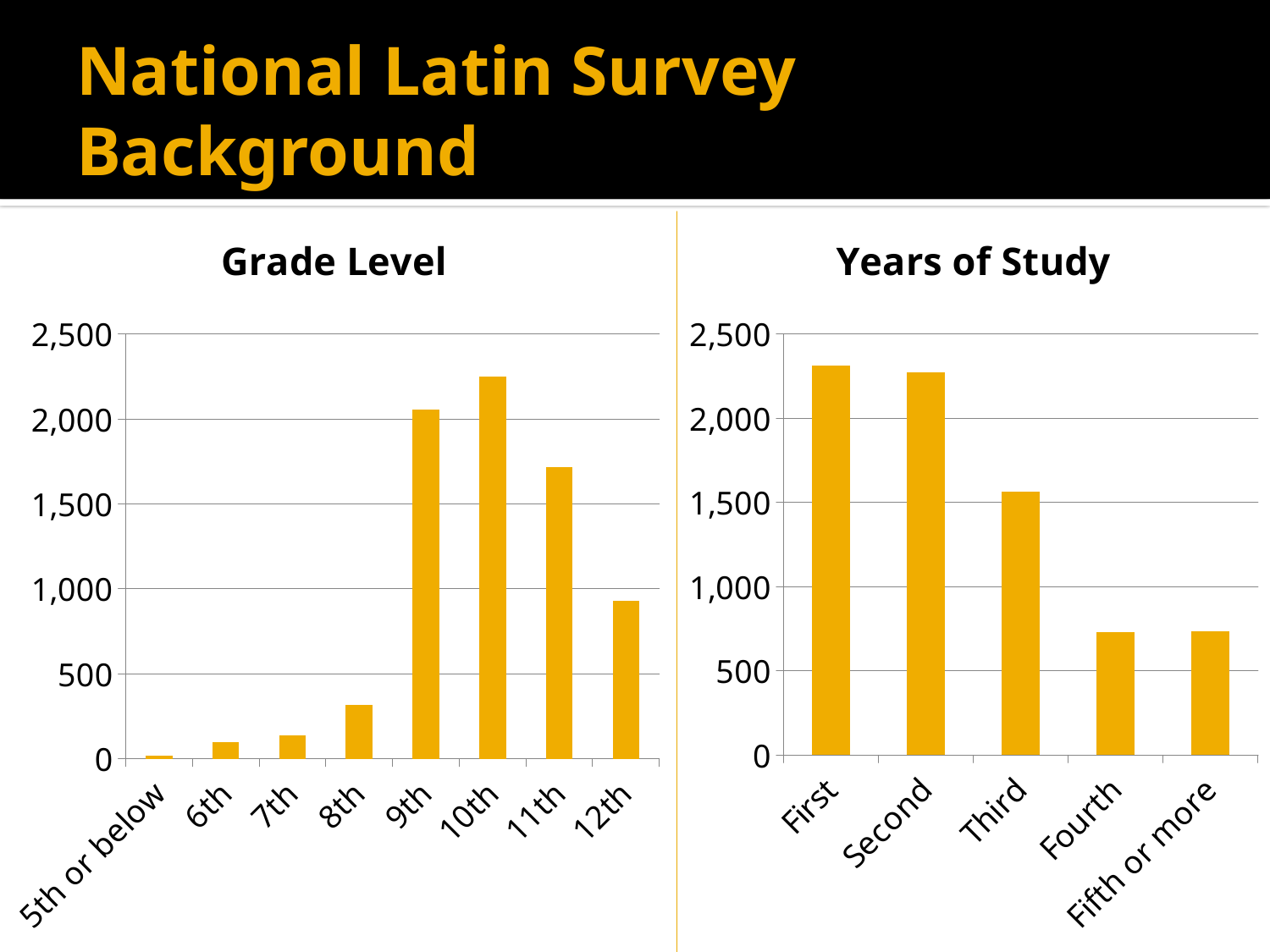
In the Grade Level chart, which category has the lowest value? 5th or below In the Grade Level chart, is the value for 12th greater or less than 1,000? less How many grade categories are shown in the Grade Level chart? 8 In the Years of Study chart, is the value for Fourth greater or less than 1,000? less In the Grade Level chart, is the value for 8th greater or less than 500? less In the Grade Level chart, which grade has the highest value? 10th In the Years of Study chart, which is larger, the value for Second or the value for Third? Second In the Grade Level chart, which is larger, the value for 11th or the value for 12th? 11th What kind of chart is the Years of Study chart? bar chart How many categories are shown in the Years of Study chart? 5